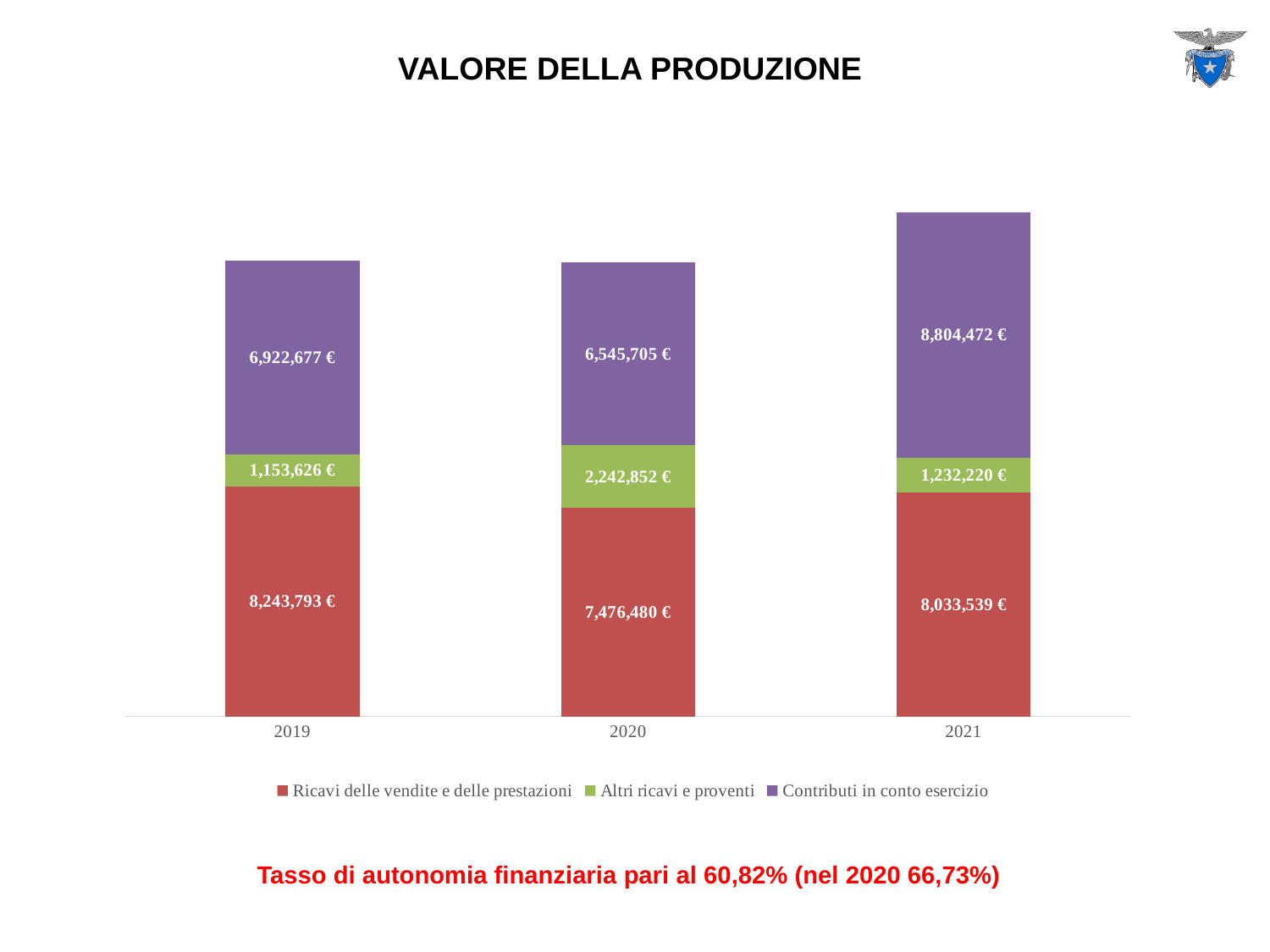
How many years are shown on the x axis? 3 What is the value of Contributi in conto esercizio for 2021? 8,804,472 € What is the value of Ricavi delle vendite e delle prestazioni for 2019? 8,243,793 € What is the difference between Contributi in conto esercizio in 2021 and in 2020? 2,258,767 € In which year is Ricavi delle vendite e delle prestazioni lowest? 2020 How many series does the legend list? 3 What is the total of the stacked bar for 2021? 18,070,231 € Which is larger: Altri ricavi e proventi in 2020 or in 2021? 2020 What type of chart is shown on the slide? Stacked bar chart In which year is Contributi in conto esercizio highest? 2021 What is the value of Altri ricavi e proventi for 2020? 2,242,852 € What is the title of the chart? VALORE DELLA PRODUZIONE